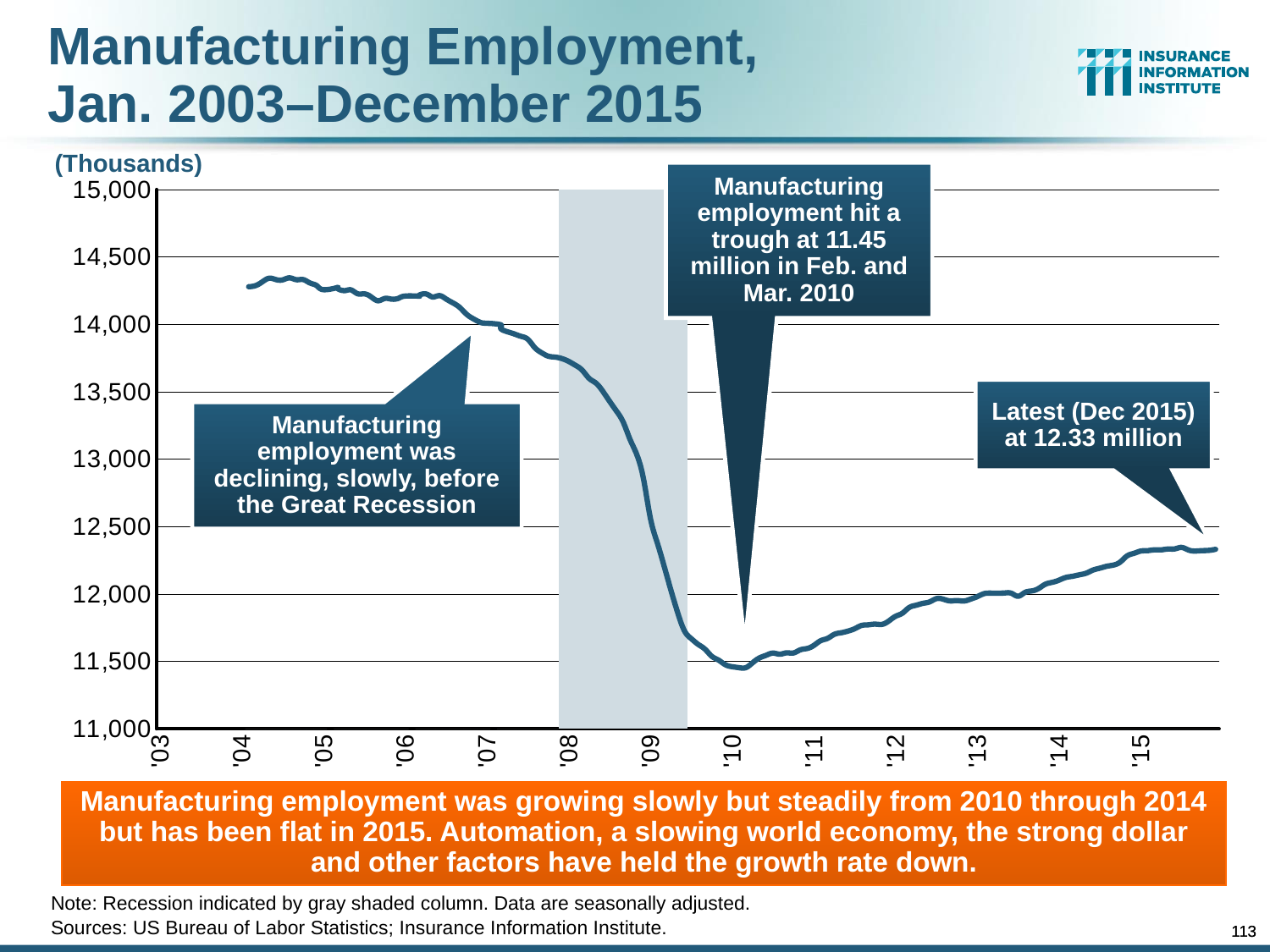
Is the manufacturing employment value at the start of 2012 greater or less than 12,000 thousand? less Is the manufacturing employment value at the start of 2014 greater or less than 12,000 thousand? greater Is the manufacturing employment value at the start of 2006 greater or less than 14,000 thousand? greater In which months and year did manufacturing employment hit its trough according to the chart? Feb. and Mar. 2010 By how much is the Dec 2015 value (12.33 million) higher than the Feb./Mar. 2010 trough (11.45 million)? 0.88 million Does manufacturing employment rise or fall between 2006 and 2009 on the chart? fall What does the gray shaded column on the chart indicate? Recession What kind of chart is shown on the slide? line chart What is the latest (Dec 2015) manufacturing employment value shown on the chart? 12.33 million According to the chart annotation, what value did manufacturing employment hit at its trough in Feb. and Mar. 2010? 11.45 million Does manufacturing employment rise or fall between 2010 and 2014 on the chart? rise Which is larger: the Dec 2015 value or the Feb./Mar. 2010 trough value? Dec 2015